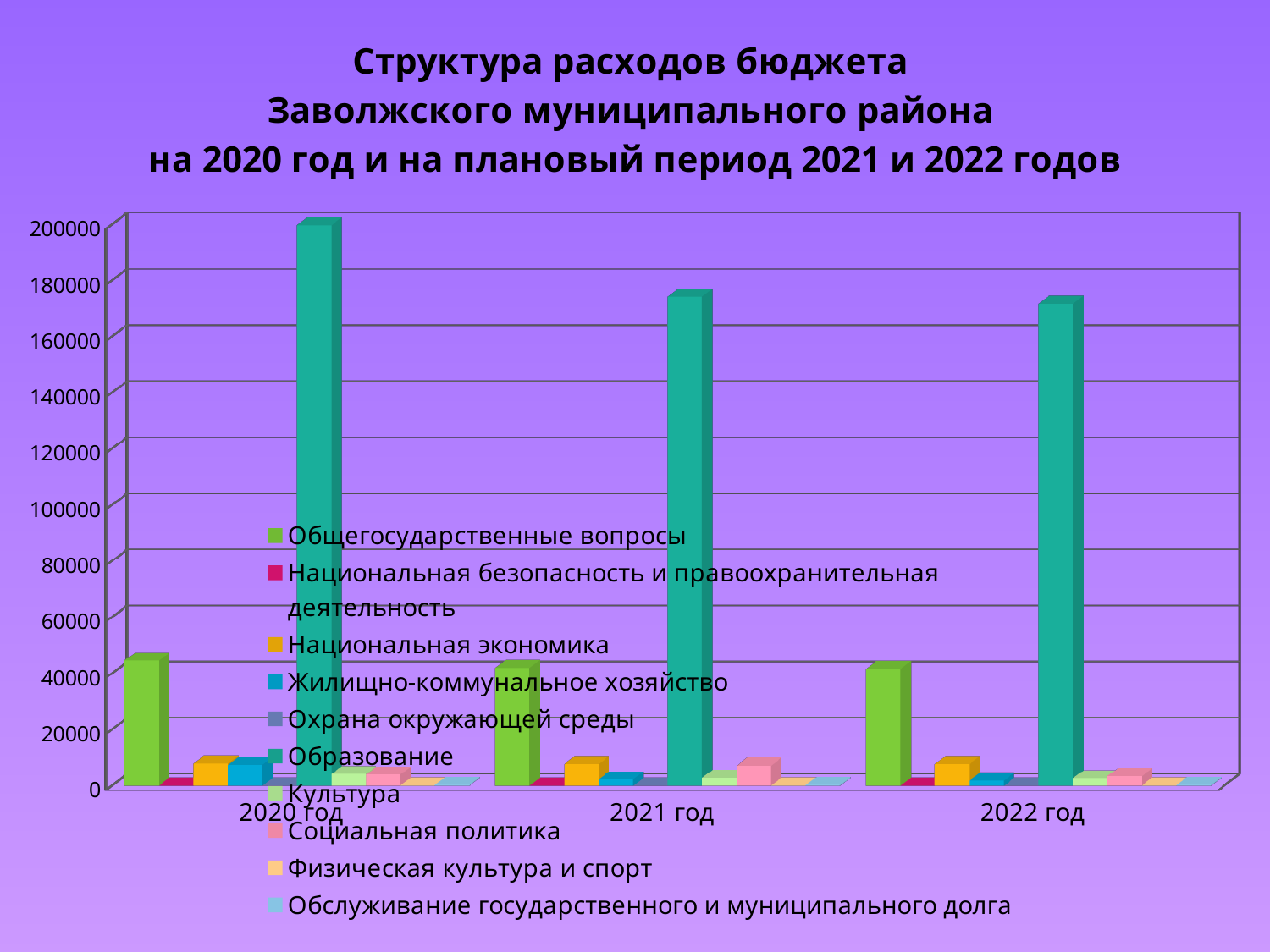
Which series has the highest value in 2022 год? Образование How many year categories are shown on the x axis? 3 Which is larger: Образование in 2020 год or Образование in 2021 год? Образование in 2020 год Is the value for Национальная экономика in 2021 год greater or less than 20000? less Which series is shown in teal in the legend? Образование How many series does the legend list? 10 Which series has the highest value in 2020 год? Образование Is the value for Общегосударственные вопросы in 2020 год greater or less than 20000? greater Does the value for Образование rise or fall from 2020 год to 2022 год? fall Is the value for Образование in 2020 год greater or less than 180000? greater What kind of chart is shown on the slide? bar chart